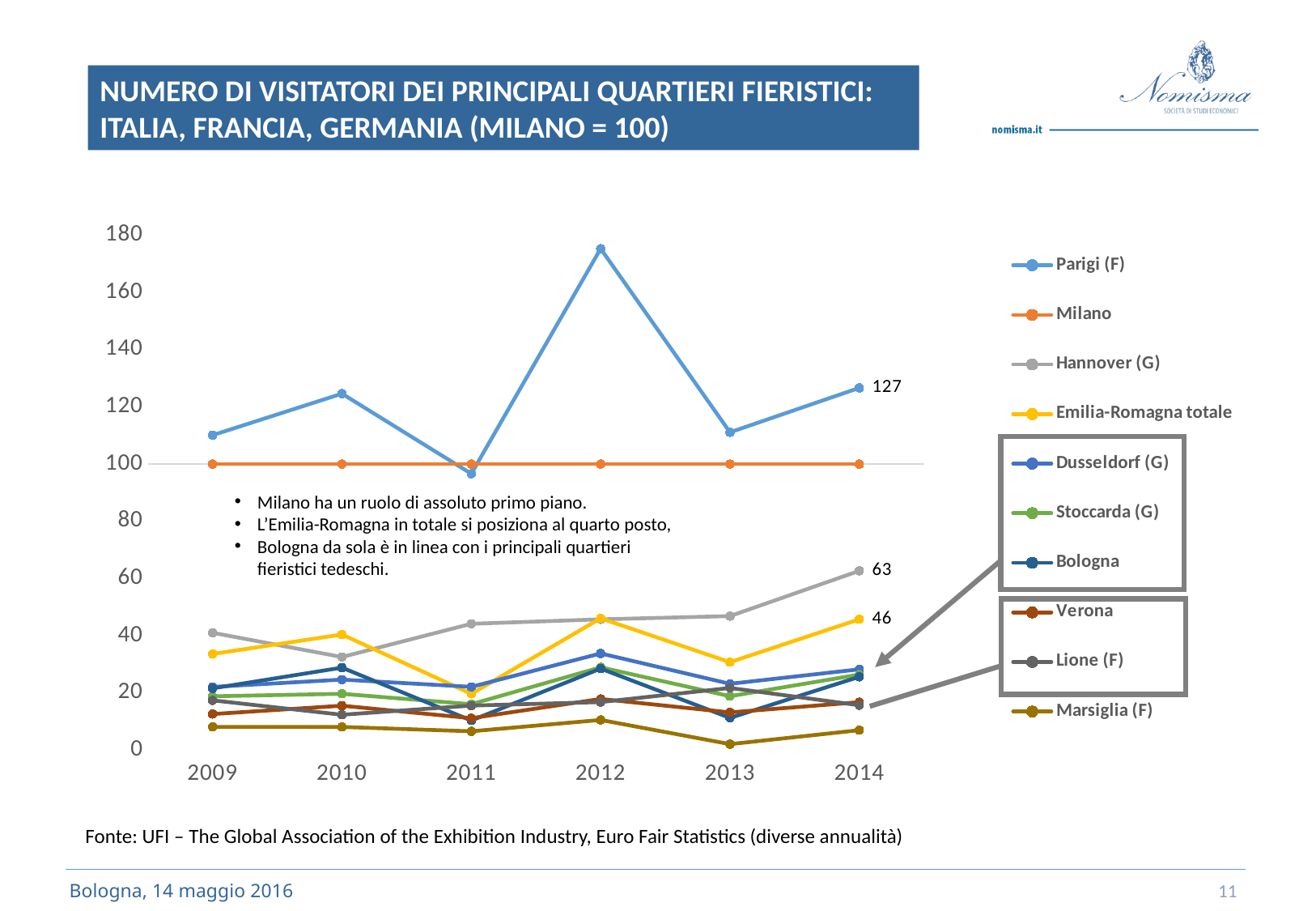
What is the value for Hannover (G) in 2014? 63 How many years are shown on the x axis? 6 What is the value for Parigi (F) in 2014? 127 Which series has the highest value in 2012? Parigi (F) Which series has the lowest value in 2014? Marsiglia (F) What kind of chart is shown on the slide? line chart Is the value for Parigi (F) in 2012 greater or less than 160? greater What is the difference between the 2014 values for Parigi (F) and Hannover (G)? 64 What is the value for Milano in 2012? 100 How many series does the legend list? 10 What is the value for Emilia-Romagna totale in 2014? 46 What is the title of the chart? NUMERO DI VISITATORI DEI PRINCIPALI QUARTIERI FIERISTICI: ITALIA, FRANCIA, GERMANIA (MILANO = 100)